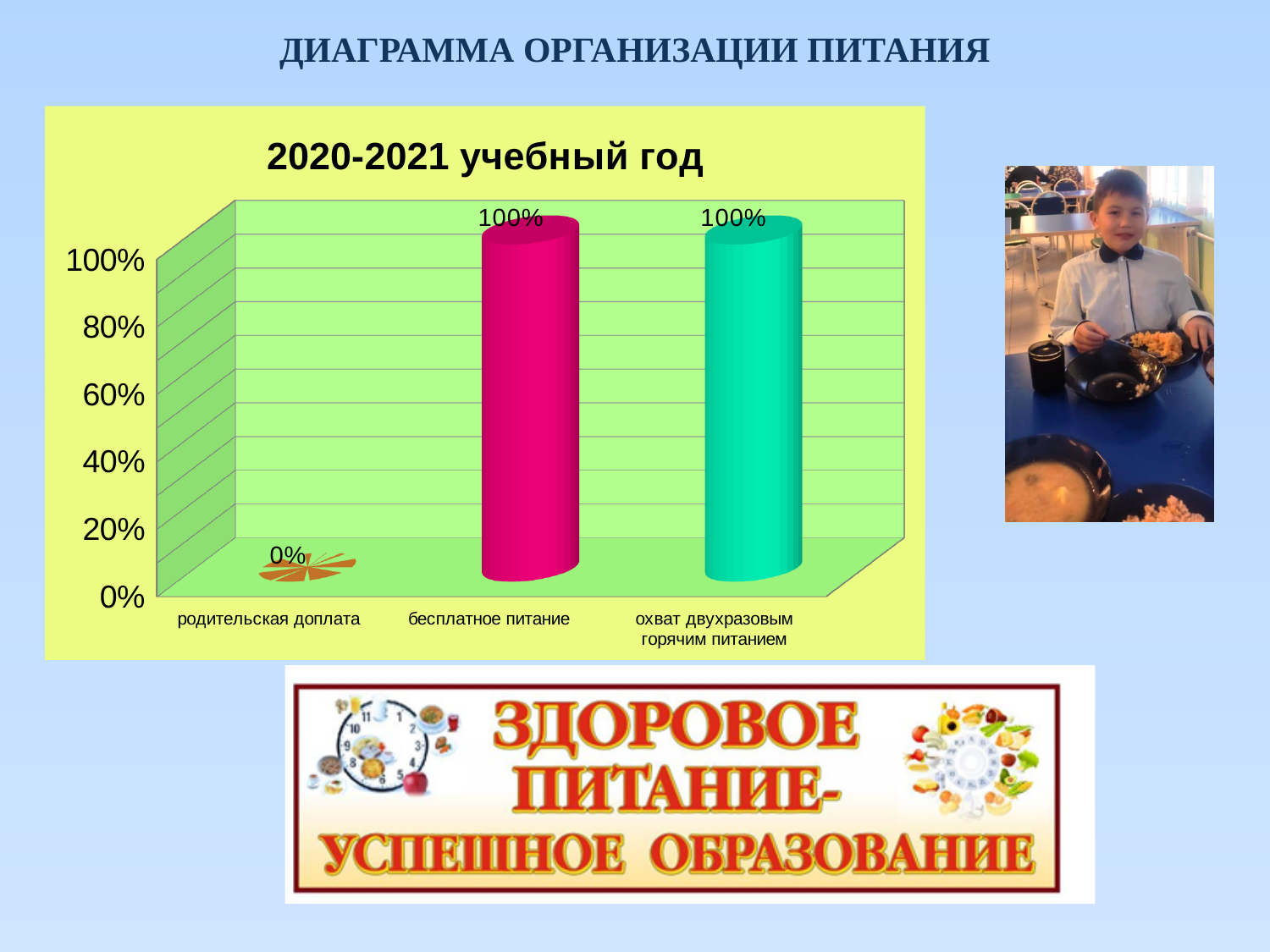
What is the value for родительская доплата? 0% What is the difference between the value for бесплатное питание and the value for родительская доплата? 100% What kind of chart is shown on the slide? bar chart How many categories are shown on the x axis? 3 Which is larger, the value for бесплатное питание or the value for родительская доплата? бесплатное питание Is the value for родительская доплата greater or less than 20%? less What is the title of the chart? 2020-2021 учебный год What is the value for охват двухразовым горячим питанием? 100% What is the value for бесплатное питание? 100% Which category has the lowest value? родительская доплата What is the highest value shown on the y axis? 100% Is the value for охват двухразовым горячим питанием greater or less than 80%? greater